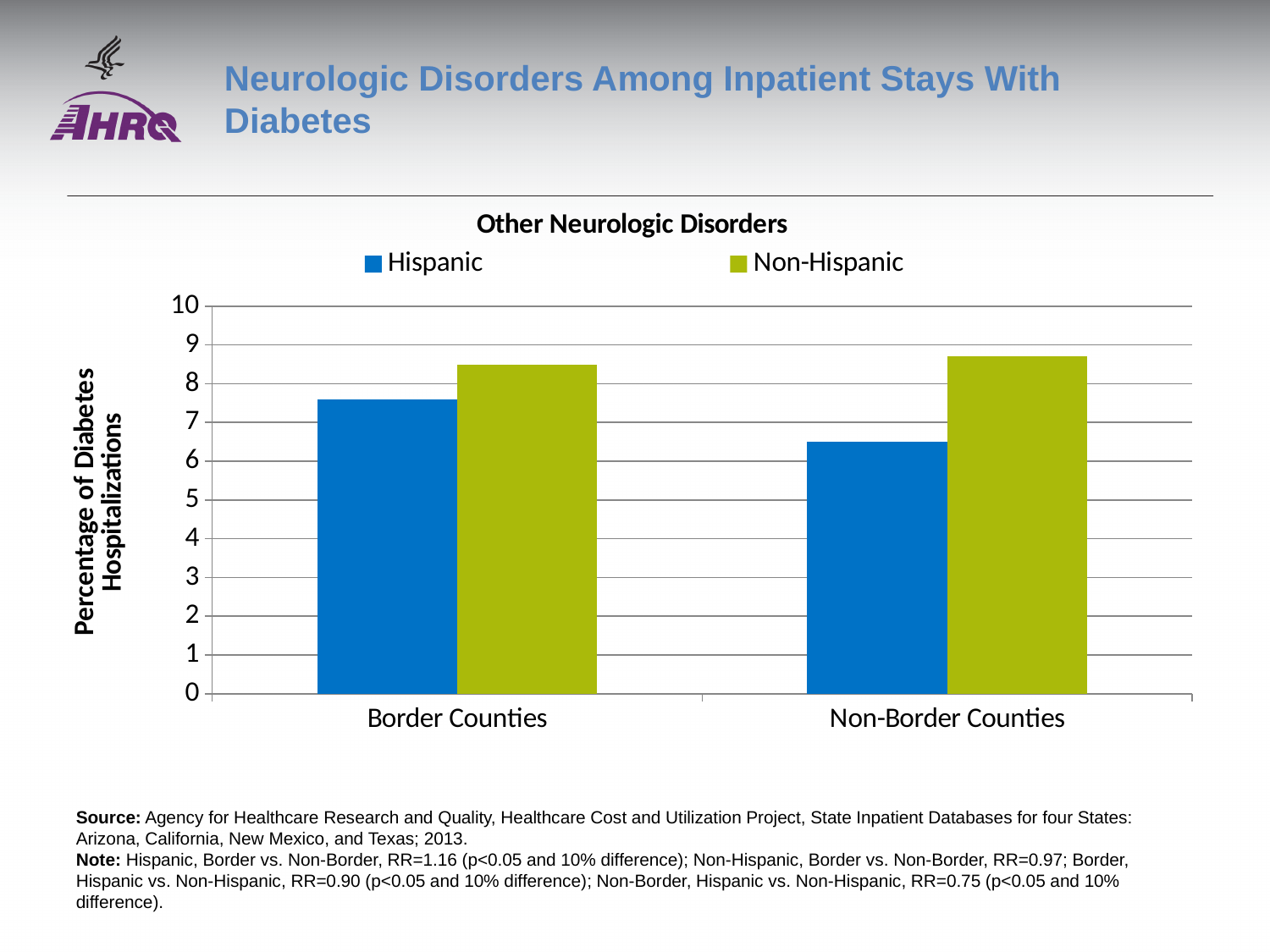
What is the y-axis label of the chart? Percentage of Diabetes Hospitalizations Is the Non-Hispanic value for Non-Border Counties greater or less than 8? greater Which bar has the lowest value in the chart? Hispanic, Non-Border Counties Is the Hispanic value for Border Counties greater or less than 7? greater How many series does the legend list? 2 What is the title of the chart? Other Neurologic Disorders Is the Non-Hispanic value for Border Counties greater or less than 8? greater In Border Counties, which group has the higher value, Hispanic or Non-Hispanic? Non-Hispanic How many categories are shown on the x axis? 2 What type of chart is shown on the slide? Bar chart